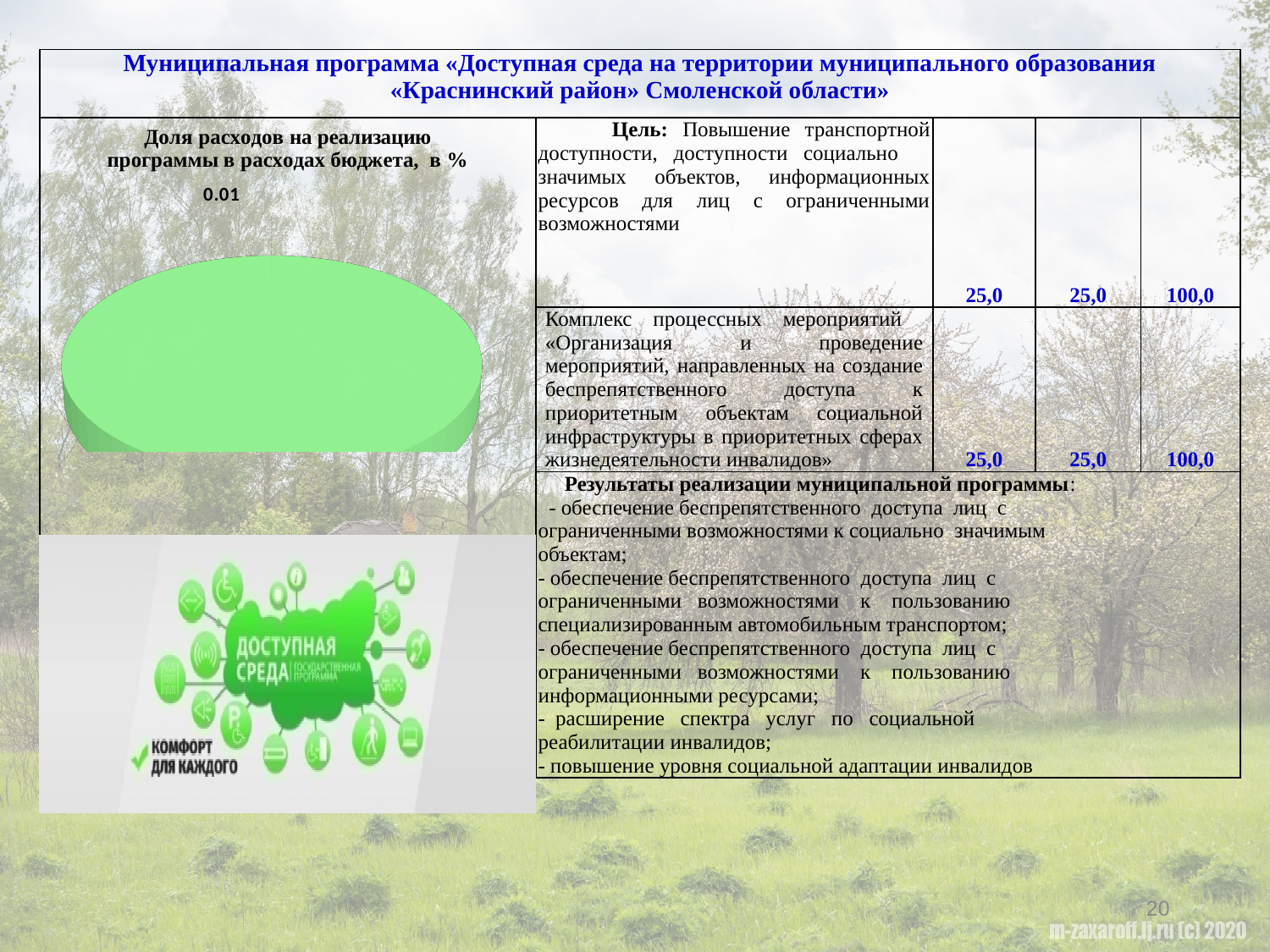
What kind of chart is shown on the left of the slide? pie chart What is the title of the pie chart? Доля расходов на реализацию программы в расходах бюджета, в % What value is printed as the data label on the pie chart? 0.01 What colour is the slice of the pie chart? green